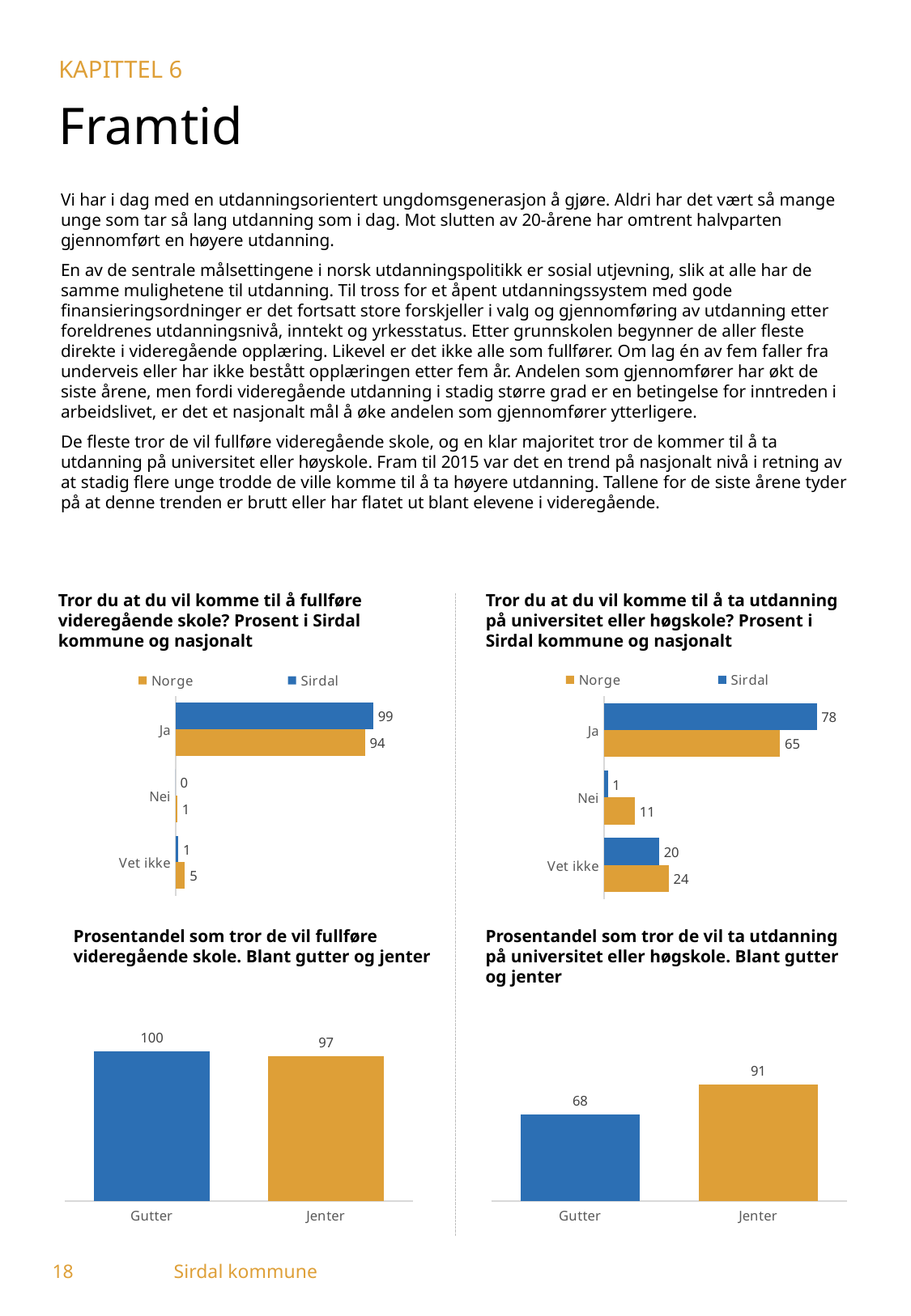
In the chart 'Tror du at du vil komme til å ta utdanning på universitet eller høgskole? Prosent i Sirdal kommune og nasjonalt', what is the value for Norge for 'Nei'? 11 In the chart 'Prosentandel som tror de vil fullføre videregående skole. Blant gutter og jenter', what is the value for Jenter? 97 In the chart 'Tror du at du vil komme til å fullføre videregående skole? Prosent i Sirdal kommune og nasjonalt', what is the difference between the Sirdal and Norge values for 'Ja'? 5 In the chart 'Prosentandel som tror de vil ta utdanning på universitet eller høgskole. Blant gutter og jenter', which category has the highest value? Jenter In the chart 'Tror du at du vil komme til å ta utdanning på universitet eller høgskole? Prosent i Sirdal kommune og nasjonalt', which is larger for 'Ja': Sirdal or Norge? Sirdal In the chart 'Prosentandel som tror de vil ta utdanning på universitet eller høgskole. Blant gutter og jenter', what is the difference between Jenter and Gutter? 23 What kind of chart is 'Prosentandel som tror de vil fullføre videregående skole. Blant gutter og jenter'? Bar chart In the chart 'Tror du at du vil komme til å ta utdanning på universitet eller høgskole? Prosent i Sirdal kommune og nasjonalt', what is the value for Sirdal for 'Vet ikke'? 20 In the chart 'Tror du at du vil komme til å fullføre videregående skole? Prosent i Sirdal kommune og nasjonalt', what is the value for Sirdal for 'Ja'? 99 How many series does the legend list in the chart 'Tror du at du vil komme til å fullføre videregående skole? Prosent i Sirdal kommune og nasjonalt'? 2 In the chart 'Tror du at du vil komme til å fullføre videregående skole? Prosent i Sirdal kommune og nasjonalt', what is the value for Norge for 'Vet ikke'? 5 How many categories are shown in the chart 'Tror du at du vil komme til å ta utdanning på universitet eller høgskole? Prosent i Sirdal kommune og nasjonalt'? 3